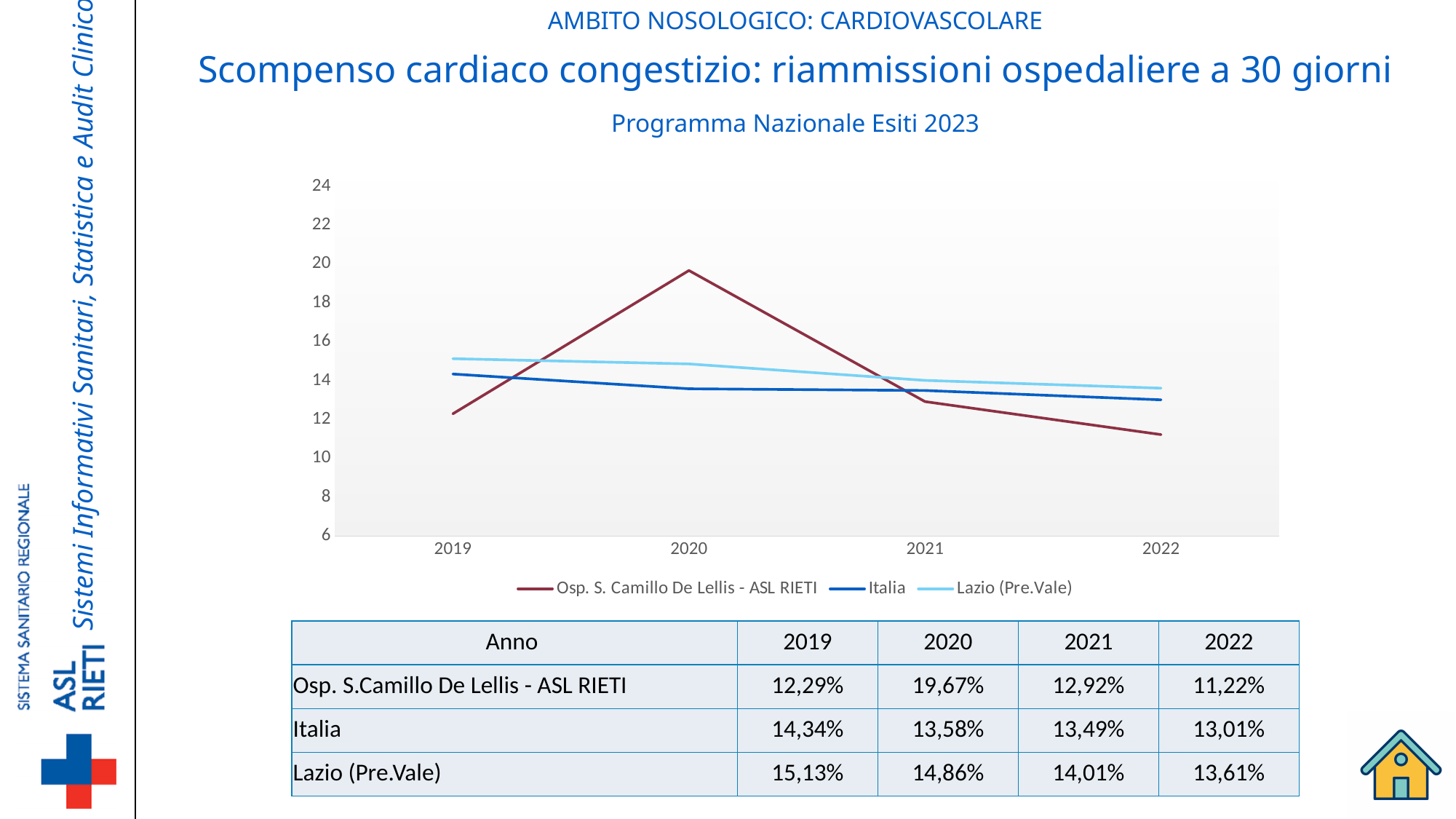
What is the value for Osp. S.Camillo De Lellis - ASL RIETI in 2020? 19,67% What is the value for Lazio (Pre.Vale) in 2022? 13,61% Does the Italia series rise or fall from 2019 to 2022? fall What is the value for Italia in 2019? 14,34% What kind of chart is shown on the slide? line chart In which year does the Osp. S.Camillo De Lellis - ASL RIETI series reach its highest value? 2020 What is the difference between the Osp. S.Camillo De Lellis - ASL RIETI value in 2020 and its value in 2019? 7,38% How many series does the chart legend list? 3 In which year does the Osp. S.Camillo De Lellis - ASL RIETI series reach its lowest value? 2022 Is the value for Osp. S. Camillo De Lellis - ASL RIETI in 2020 greater or less than 18? greater Which series has the larger value in 2021, Italia or Lazio (Pre.Vale)? Lazio (Pre.Vale) How many years are plotted along the x axis of the chart? 4